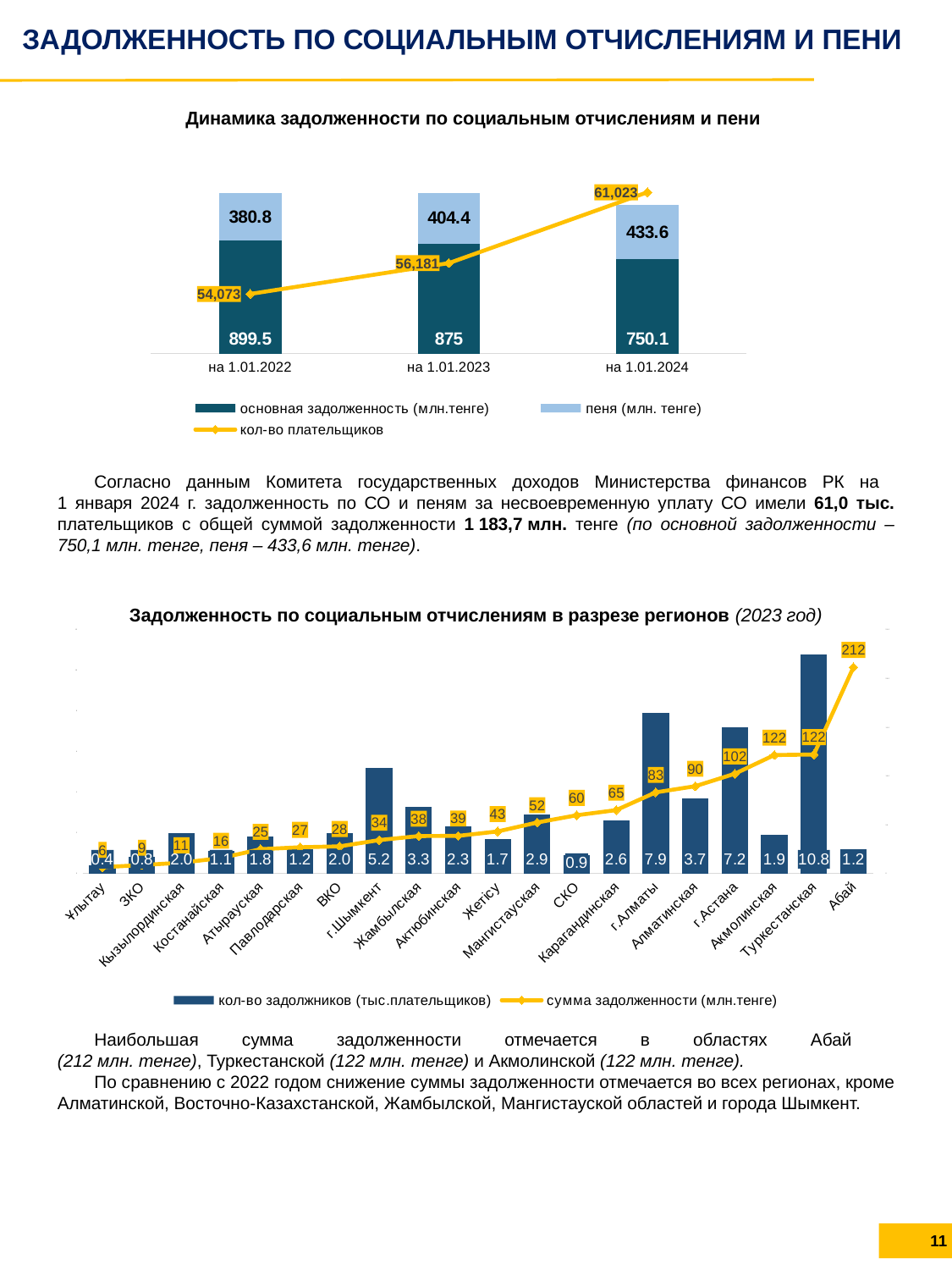
In the chart 'Динамика задолженности по социальным отчислениям и пени', does основная задолженность rise or fall from 1.01.2022 to 1.01.2024? fall In the chart 'Задолженность по социальным отчислениям в разрезе регионов (2023 год)', how many regions are shown on the x axis? 20 In the chart 'Задолженность по социальным отчислениям в разрезе регионов (2023 год)', which region has the highest сумма задолженности? Абай In the chart 'Динамика задолженности по социальным отчислениям и пени', what is the кол-во плательщиков на 1.01.2022? 54,073 In the chart 'Динамика задолженности по социальным отчислениям и пени', what is the value of пеня на 1.01.2023? 404.4 In the chart 'Динамика задолженности по социальным отчислениям и пени', what is the total of the stacked bar на 1.01.2022? 1280.3 In the chart 'Динамика задолженности по социальным отчислениям и пени', how many series does the legend list? 3 In the chart 'Задолженность по социальным отчислениям в разрезе регионов (2023 год)', which region has the lowest кол-во задолжников? Ұлытау In the chart 'Задолженность по социальным отчислениям в разрезе регионов (2023 год)', what is the кол-во задолжников for Туркестанская? 10.8 In the chart 'Задолженность по социальным отчислениям в разрезе регионов (2023 год)', which has the larger кол-во задолжников, г.Алматы or г.Астана? г.Алматы In the chart 'Динамика задолженности по социальным отчислениям и пени', what is the value of основная задолженность на 1.01.2024? 750.1 In the chart 'Динамика задолженности по социальным отчислениям и пени', what is the difference in кол-во плательщиков between 1.01.2024 and 1.01.2023? 4,842